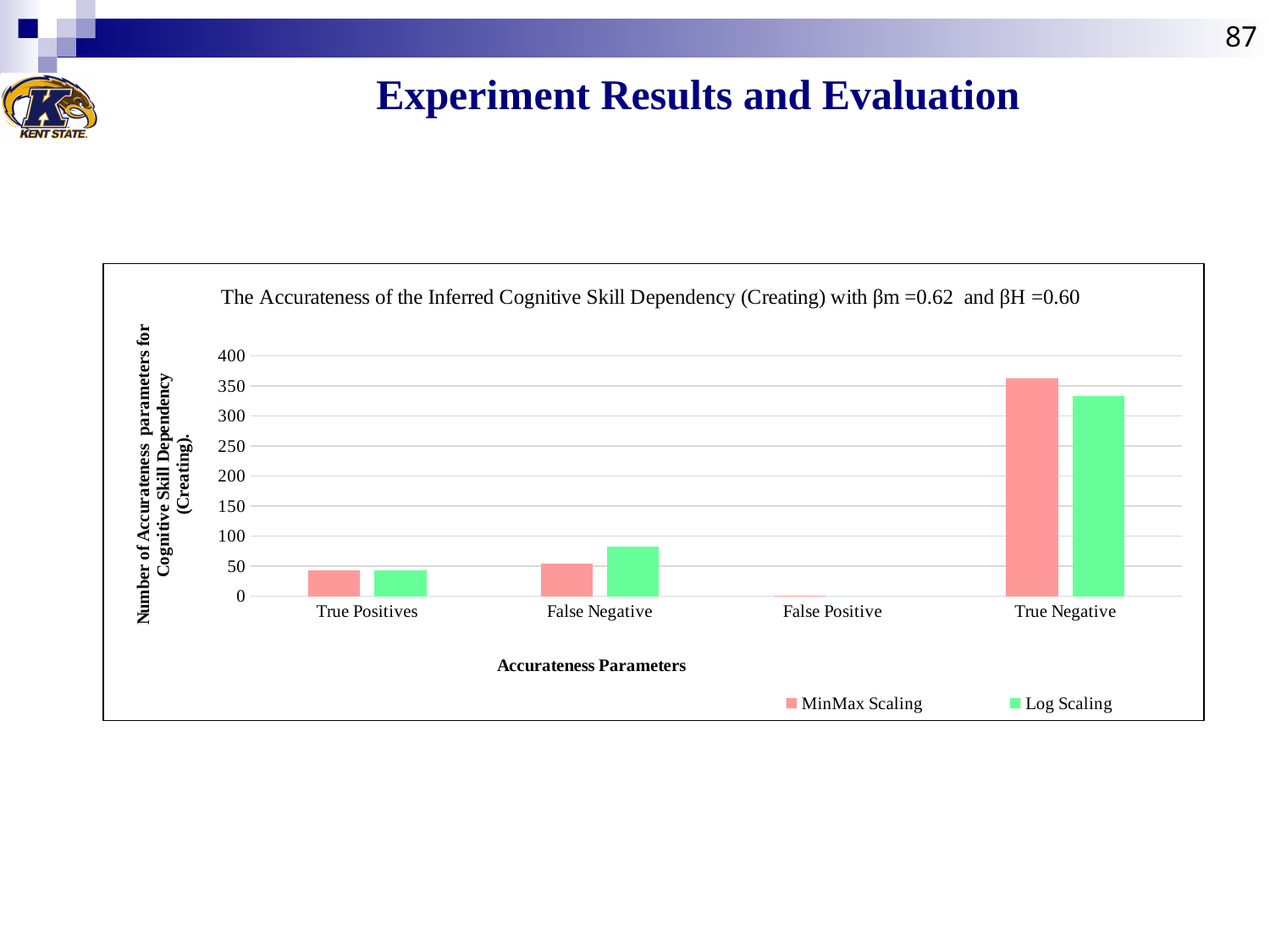
For False Negative, which series has the larger value, MinMax Scaling or Log Scaling? Log Scaling Which category has the highest value for MinMax Scaling? True Negative For True Negative, which series has the larger value, MinMax Scaling or Log Scaling? MinMax Scaling Is the value for False Negative under Log Scaling greater or less than 100? less What kind of chart is shown on the slide? bar chart Which category has the lowest value for Log Scaling? False Positive How many categories are shown on the x axis of the chart? 4 Is the value for True Negative under Log Scaling greater or less than 300? greater How many series does the chart's legend list? 2 What are the two series named in the chart's legend? MinMax Scaling and Log Scaling Is the value for True Positives under MinMax Scaling greater or less than 100? less What is the x-axis title of the chart? Accurateness Parameters